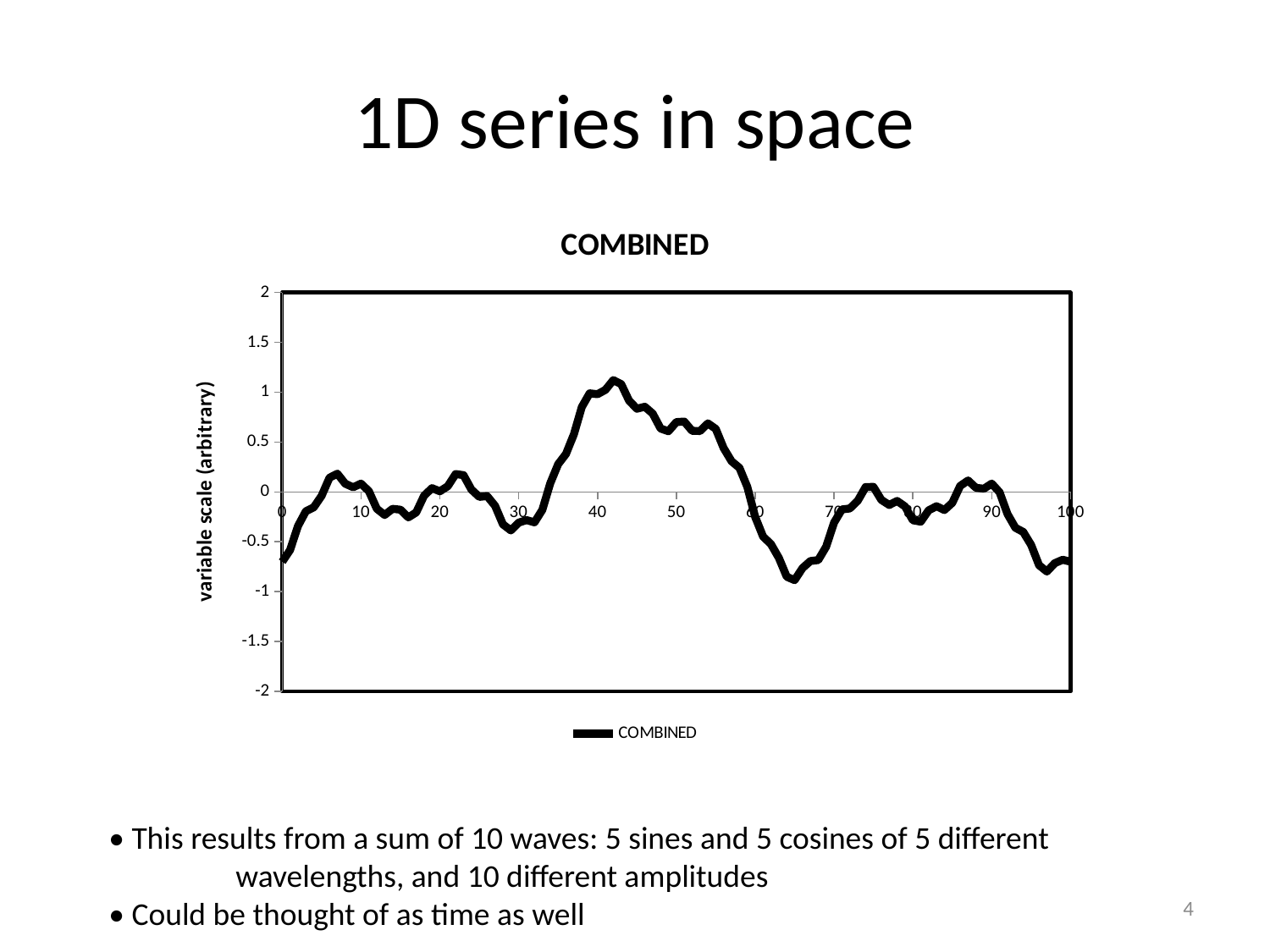
Is the value of the COMBINED line at x = 0 greater or less than 0? less What kind of chart is shown on the slide? line chart Is the lowest value reached by the COMBINED line greater or less than -1.5? greater How many series does the legend list? 1 Is the value of the COMBINED line at x = 30 greater or less than 0? less What is the label on the vertical axis of the chart? variable scale (arbitrary) Between x = 30 and x = 40, does the COMBINED line rise or fall? rise What is the title of the chart? COMBINED Between x = 55 and x = 65, does the COMBINED line rise or fall? fall